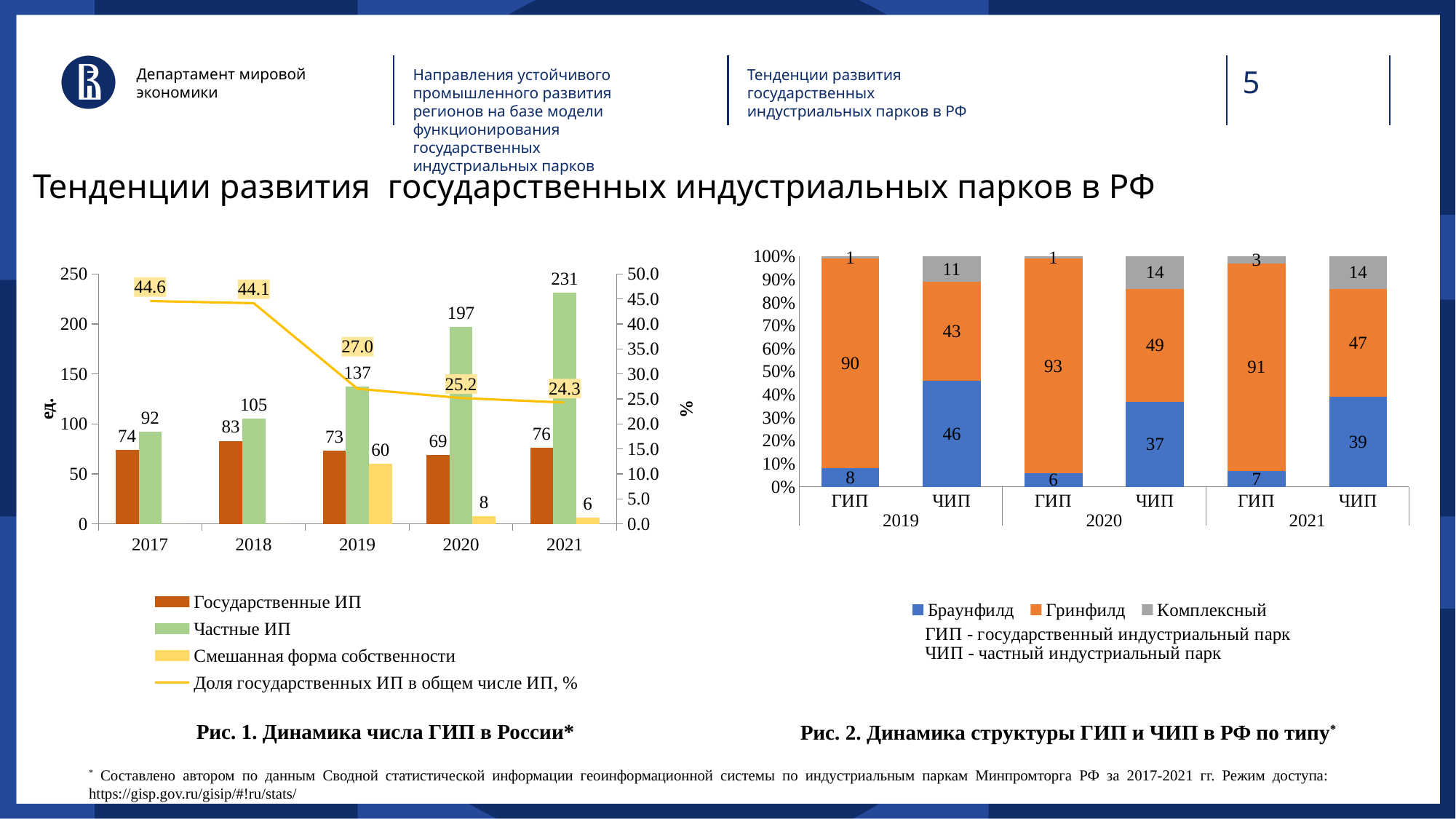
In the chart 'Рис. 2. Динамика структуры ГИП и ЧИП в РФ по типу', which is larger for ЧИП in 2019: Браунфилд or Гринфилд? Браунфилд In the chart 'Рис. 1. Динамика числа ГИП в России', how many series does the legend list? 4 In the chart 'Рис. 1. Динамика числа ГИП в России', does the line 'Доля государственных ИП в общем числе ИП, %' rise or fall from 2017 to 2021? fall In the chart 'Рис. 2. Динамика структуры ГИП и ЧИП в РФ по типу', what is the Комплексный value for ЧИП in 2021? 14 In the chart 'Рис. 1. Динамика числа ГИП в России', in which year is the value for Государственные ИП lowest? 2020 In the chart 'Рис. 1. Динамика числа ГИП в России', what is the value for Частные ИП in 2021? 231 In the chart 'Рис. 1. Динамика числа ГИП в России', what is the value of the line 'Доля государственных ИП в общем числе ИП, %' in 2019? 27.0 In the chart 'Рис. 1. Динамика числа ГИП в России', what is the difference between Частные ИП and Государственные ИП in 2020? 128 In the chart 'Рис. 1. Динамика числа ГИП в России', what is the value for Смешанная форма собственности in 2019? 60 What type of chart is 'Рис. 2. Динамика структуры ГИП и ЧИП в РФ по типу'? stacked bar chart In the chart 'Рис. 2. Динамика структуры ГИП и ЧИП в РФ по типу', how many stacked bars are shown? 6 In the chart 'Рис. 2. Динамика структуры ГИП и ЧИП в РФ по типу', what is the Гринфилд value for ГИП in 2020? 93